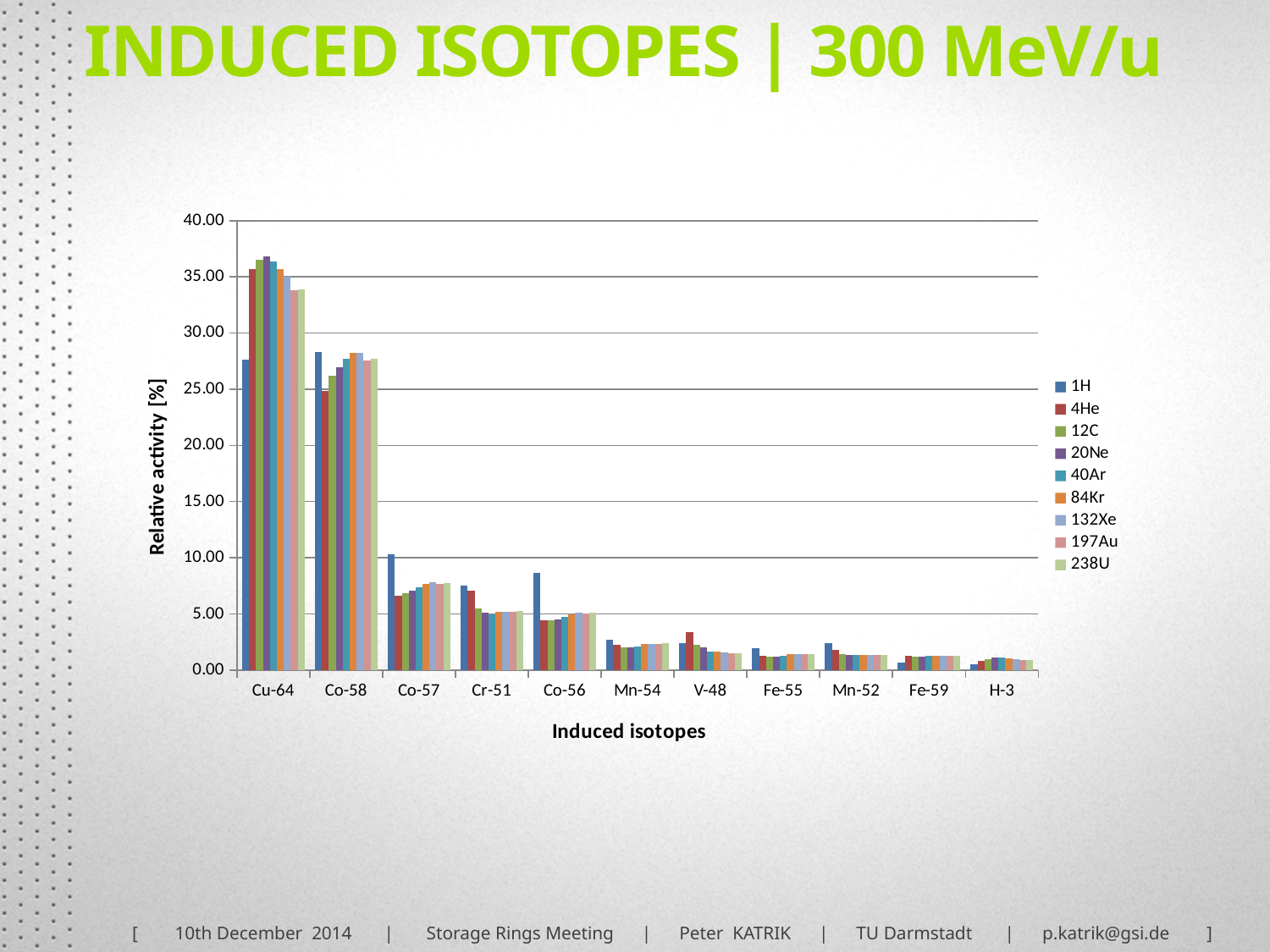
Is the value for 1H at Co-56 greater or less than 5.00? greater For Co-58, which series has the lowest relative activity? 4He For Cu-64, which series has the lowest relative activity? 1H Which induced isotope has the highest relative activity? Cu-64 How many series does the legend list? 9 Is the value for 1H at Cu-64 greater or less than 30.00? less Which induced isotope has the lowest relative activity? H-3 Is the value for 238U at Cu-64 greater or less than 30.00? greater For Cu-64, which is larger: the value for 1H or the value for 12C? 12C How many induced isotopes are shown on the x axis? 11 What is the label of the y axis? Relative activity [%] What kind of chart is shown on the slide? bar chart